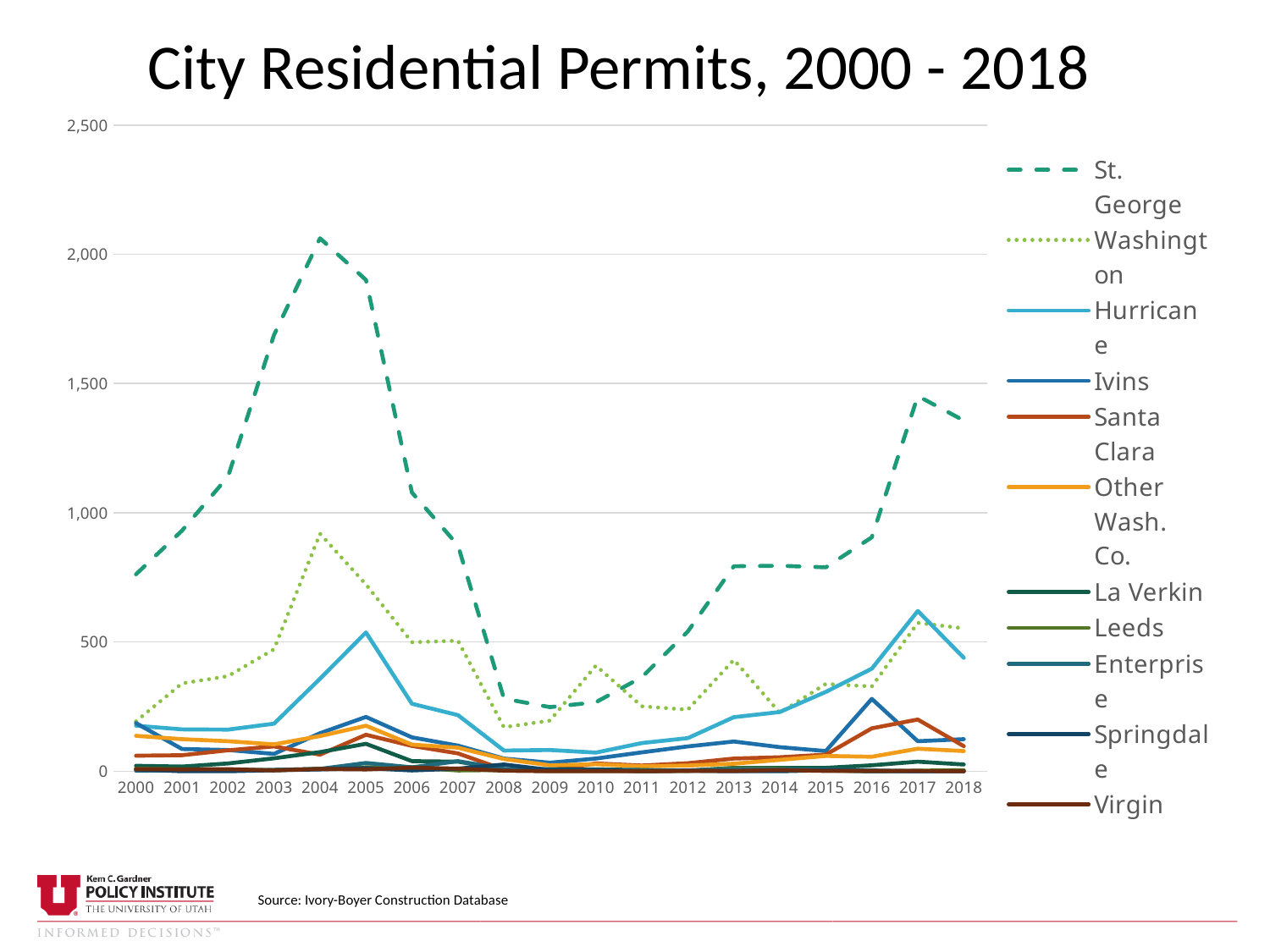
Is the value for St. George in 2008 greater or less than 500? less What source is cited for the chart? Ivory-Boyer Construction Database How many years are plotted along the x axis? 19 What kind of chart is shown on the slide? line chart Is the value for Hurricane in 2005 greater or less than 500? greater Is the value for Washington in 2004 greater or less than 1,000? less Does the St. George line rise or fall between 2004 and 2008? fall In which year does the St. George line reach its highest point? 2004 What is the title of the chart? City Residential Permits, 2000 - 2018 How many series does the legend list? 11 Which series has the larger value in 2004, St. George or Washington? St. George